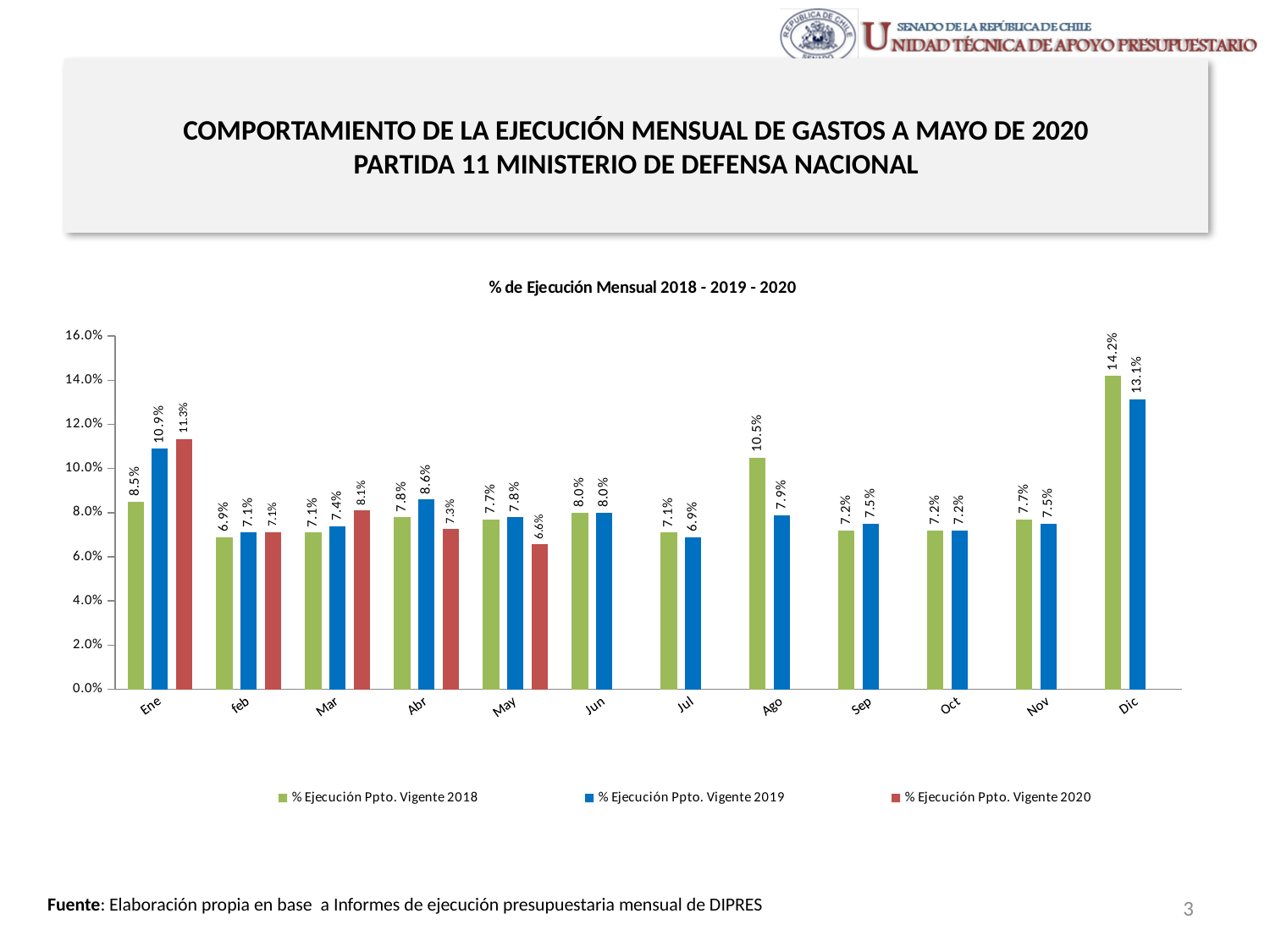
What is the value for % Ejecución Ppto. Vigente 2019 in Abr? 8.6% What is the title of the chart? % de Ejecución Mensual 2018 - 2019 - 2020 Which month has the lowest value for % Ejecución Ppto. Vigente 2020? May Which is larger in Ago: the 2018 value or the 2019 value? 2018 How many series does the legend list? 3 Which month has the highest value for % Ejecución Ppto. Vigente 2018? Dic What is the value for % Ejecución Ppto. Vigente 2018 in Ago? 10.5% What kind of chart is shown on the slide? Bar chart What is the value for % Ejecución Ppto. Vigente 2020 in Ene? 11.3% Is the value for % Ejecución Ppto. Vigente 2019 in Ene greater or less than 10.0%? greater What is the difference between the 2018 and 2019 values in Dic? 1.1% How many months are shown on the x axis? 12